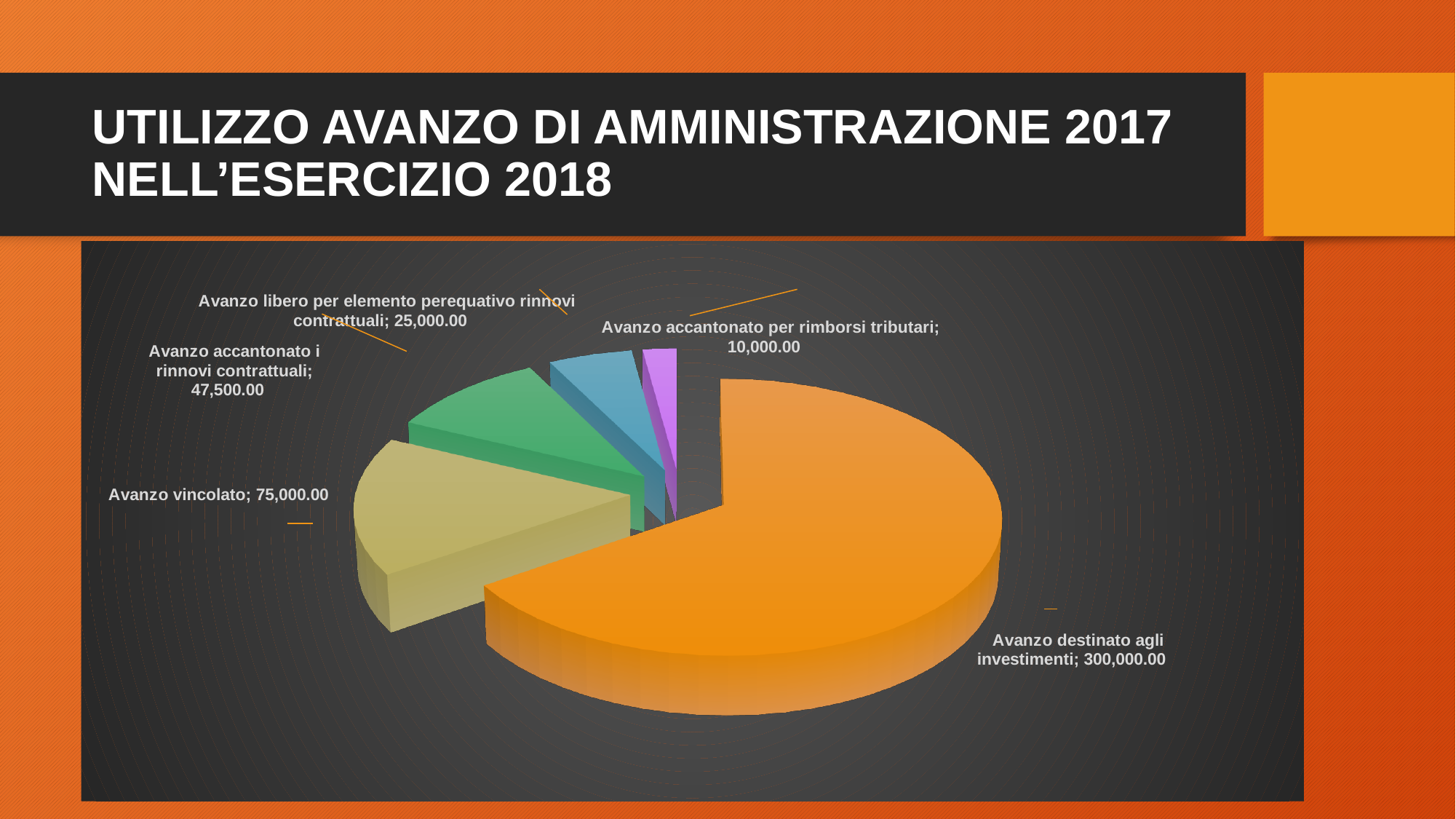
What colour is the slice for "Avanzo destinato agli investimenti"? Orange How many slices does the pie chart have? 5 What kind of chart is shown on the slide? Pie chart What is the value for "Avanzo vincolato"? 75,000.00 What is the value for "Avanzo accantonato i rinnovi contrattuali"? 47,500.00 What is the difference between the values for "Avanzo destinato agli investimenti" and "Avanzo vincolato"? 225,000.00 Which is larger: "Avanzo vincolato" or "Avanzo libero per elemento perequativo rinnovi contrattuali"? Avanzo vincolato What is the value for "Avanzo destinato agli investimenti"? 300,000.00 What is the title of the slide containing the pie chart? UTILIZZO AVANZO DI AMMINISTRAZIONE 2017 NELL'ESERCIZIO 2018 What is the value for "Avanzo accantonato per rimborsi tributari"? 10,000.00 Which category has the smallest slice of the pie? Avanzo accantonato per rimborsi tributari Which category has the largest slice of the pie? Avanzo destinato agli investimenti